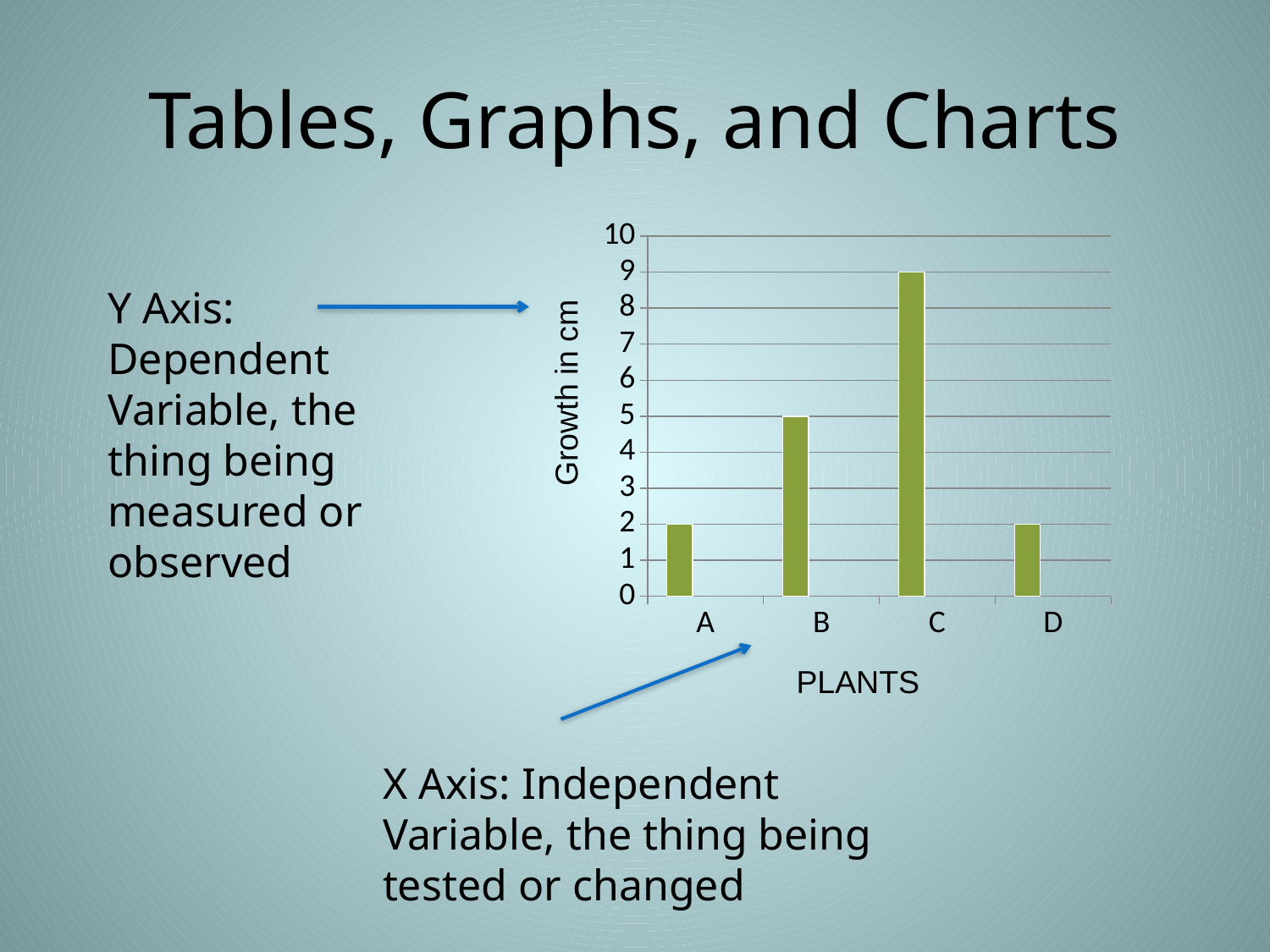
What is the growth in cm for plant C? 9 Which plant has greater growth, B or D? B How many plants are shown on the x axis of the chart? 4 What is the label on the y axis of the chart? Growth in cm What type of chart is shown on the slide? bar chart What is the growth in cm for plant B? 5 What is the difference in growth between plant B and plant A? 3 What is the difference in growth between plant C and plant B? 4 What is the growth in cm for plant A? 2 Is the growth for plant C greater or less than 8? greater What is the growth in cm for plant D? 2 Which plant has the highest growth? C